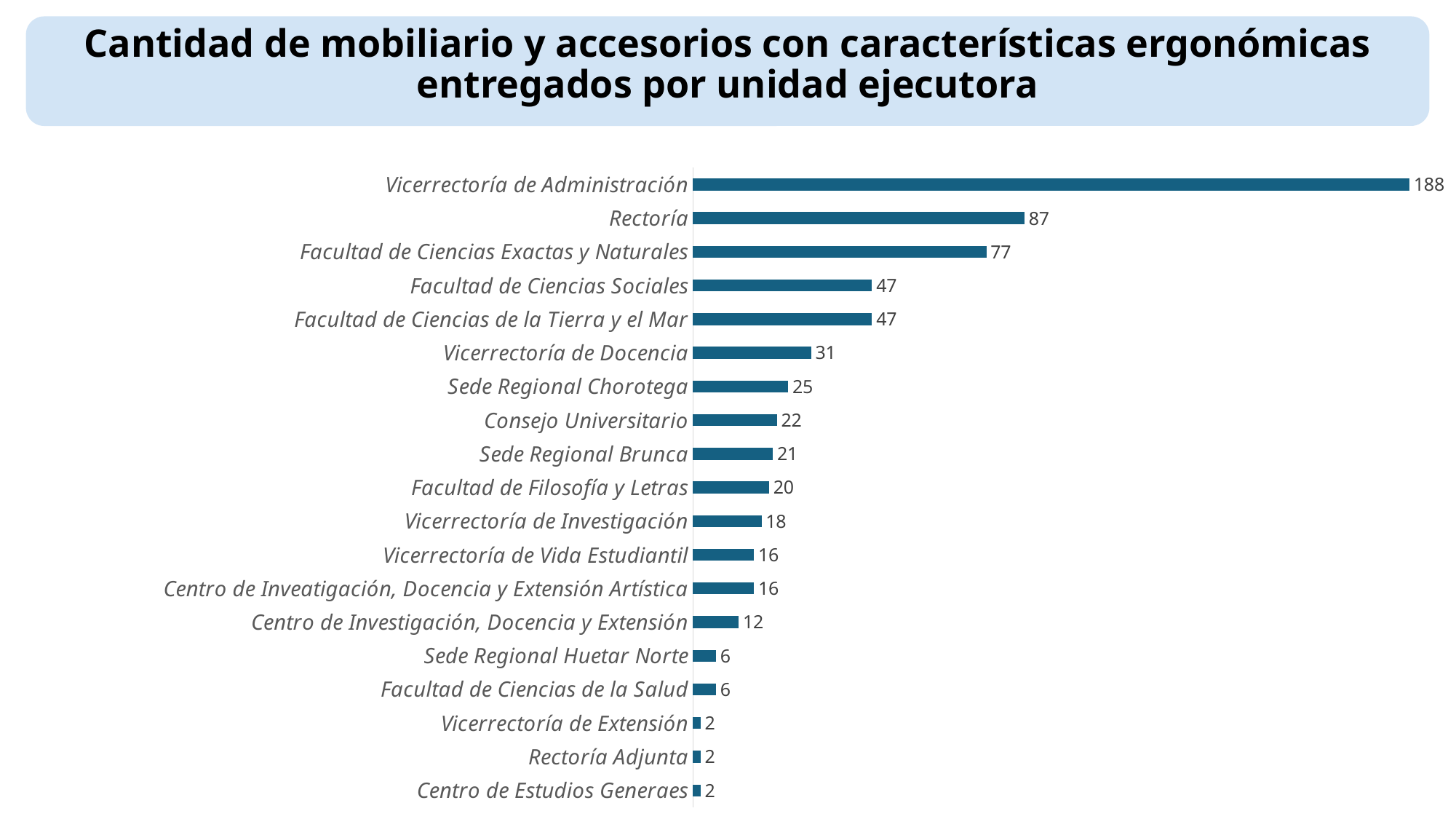
What value is shown for Centro de Investigación, Docencia y Extensión? 12 What kind of chart is shown on the slide? Bar chart What value is shown for Rectoría? 87 Which is larger, the value for Sede Regional Brunca or the value for Facultad de Ciencias de la Salud? Sede Regional Brunca What is the difference between the values for Facultad de Ciencias Exactas y Naturales and Facultad de Ciencias Sociales? 30 What is the title of the slide? Cantidad de mobiliario y accesorios con características ergonómicas entregados por unidad ejecutora What value is shown for Vicerrectoría de Administración? 188 What value is shown for Sede Regional Chorotega? 25 How many units are listed in the chart? 19 What is the difference between the values for Vicerrectoría de Administración and Rectoría? 101 Which unit has the highest value? Vicerrectoría de Administración Which is larger, the value for Vicerrectoría de Docencia or the value for Consejo Universitario? Vicerrectoría de Docencia